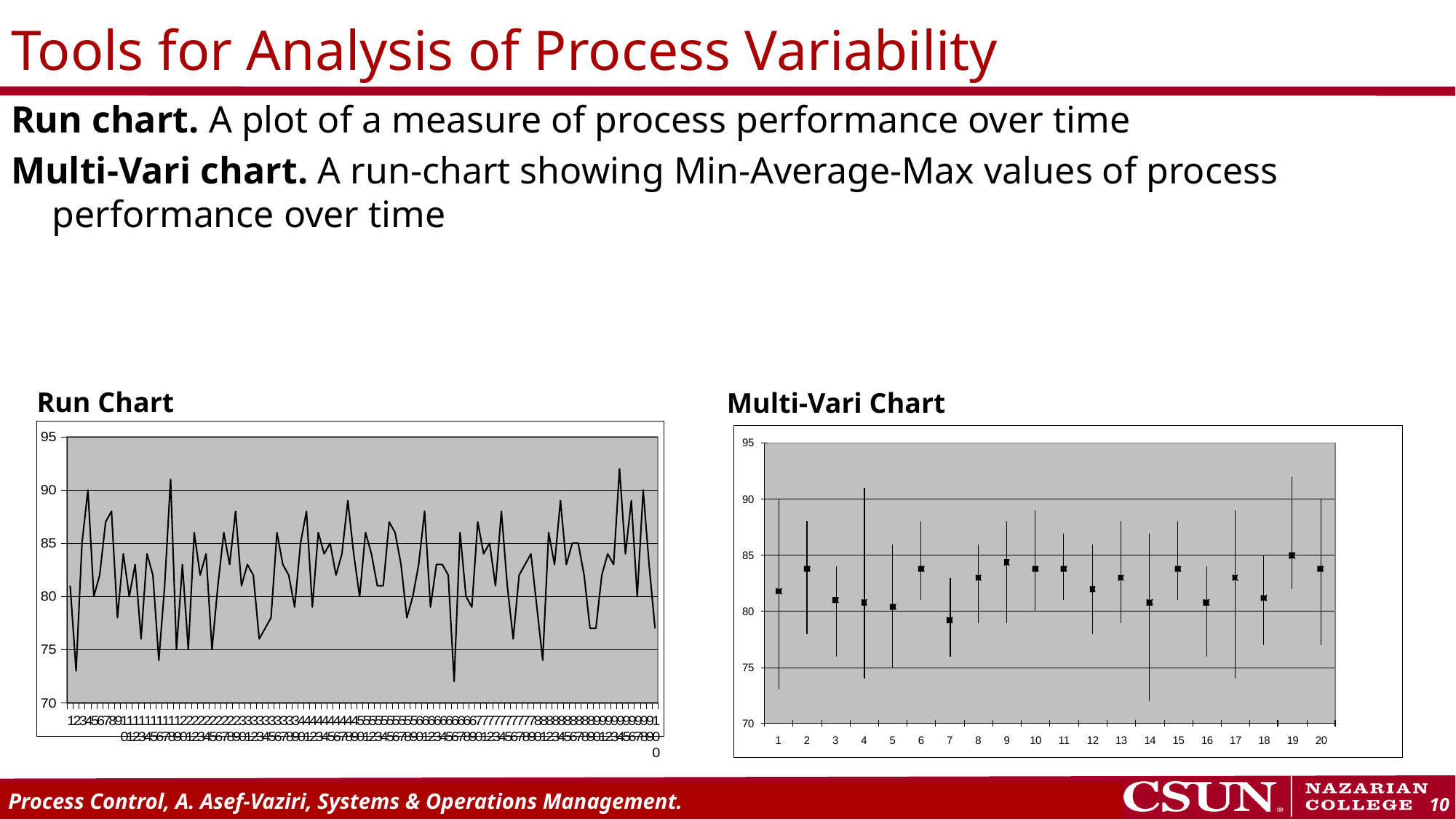
In the Multi-Vari Chart, which period has the lowest average marker? 7 In the Run Chart, is the lowest plotted value greater or less than 75? less In the Multi-Vari Chart, how many time periods are shown on the x axis? 20 In the Multi-Vari Chart, is the minimum value for period 14 greater or less than 75? less In the Multi-Vari Chart, is the average value for period 9 greater or less than 80? greater In the Multi-Vari Chart, is the average for period 9 larger or smaller than the average for period 7? larger What kind of chart is the Run Chart on the left of the slide? line chart What is the lowest value shown on the y axis of the Multi-Vari Chart? 70 What is the highest value shown on the y axis of the Run Chart? 95